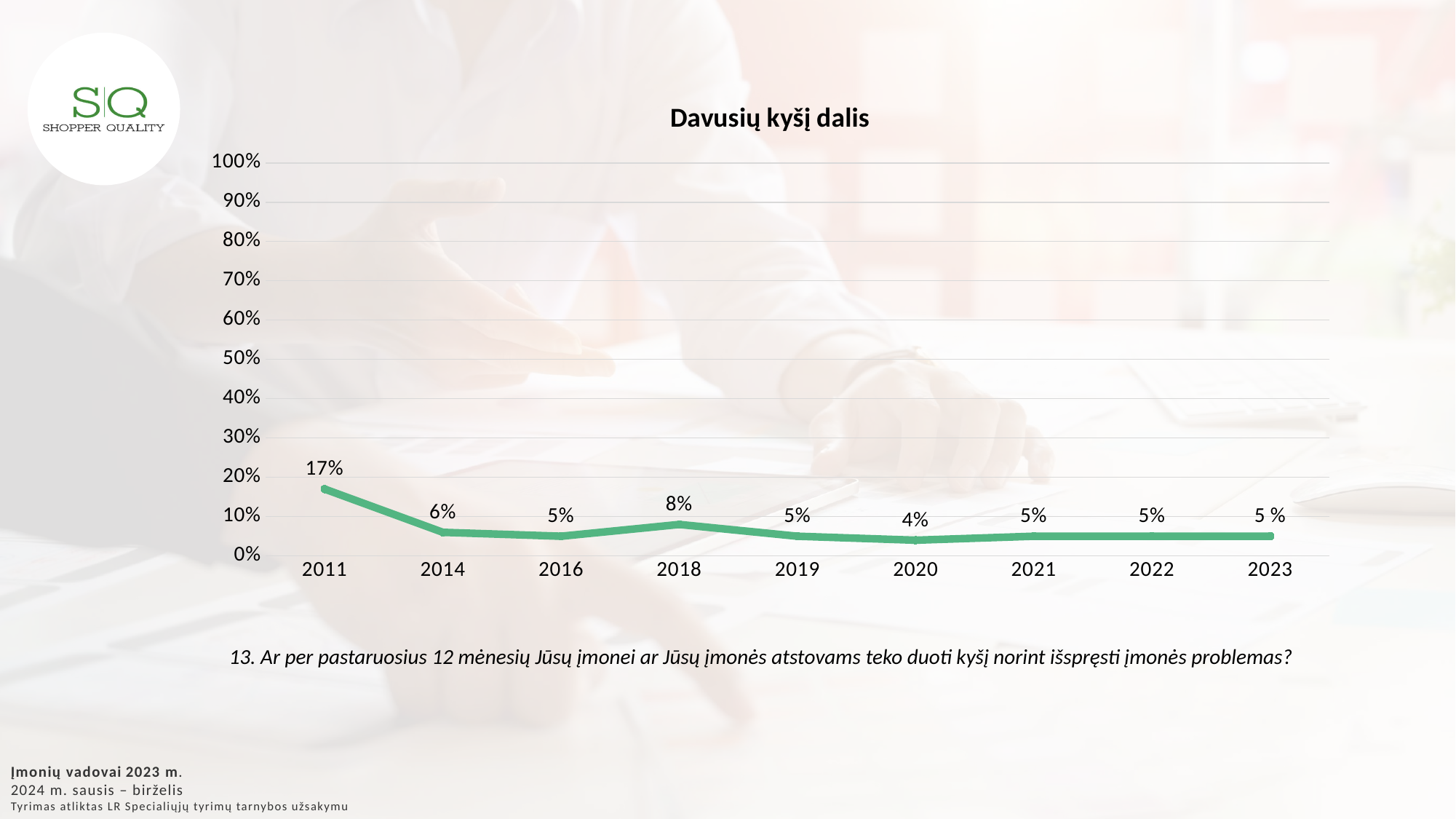
How many years are plotted on the chart? 9 What is the difference between the values for 2018 and 2020? 4% What is the value for 2020? 4% What is the value for 2023? 5 % What is the title of the chart? Davusių kyšį dalis What is the value for 2011? 17% What is the difference between the values for 2011 and 2014? 11% What kind of chart is shown? line chart Which year has the lowest value? 2020 Which year has the highest value? 2011 What is the value for 2018? 8% Which is larger, the value for 2014 or the value for 2018? 2018